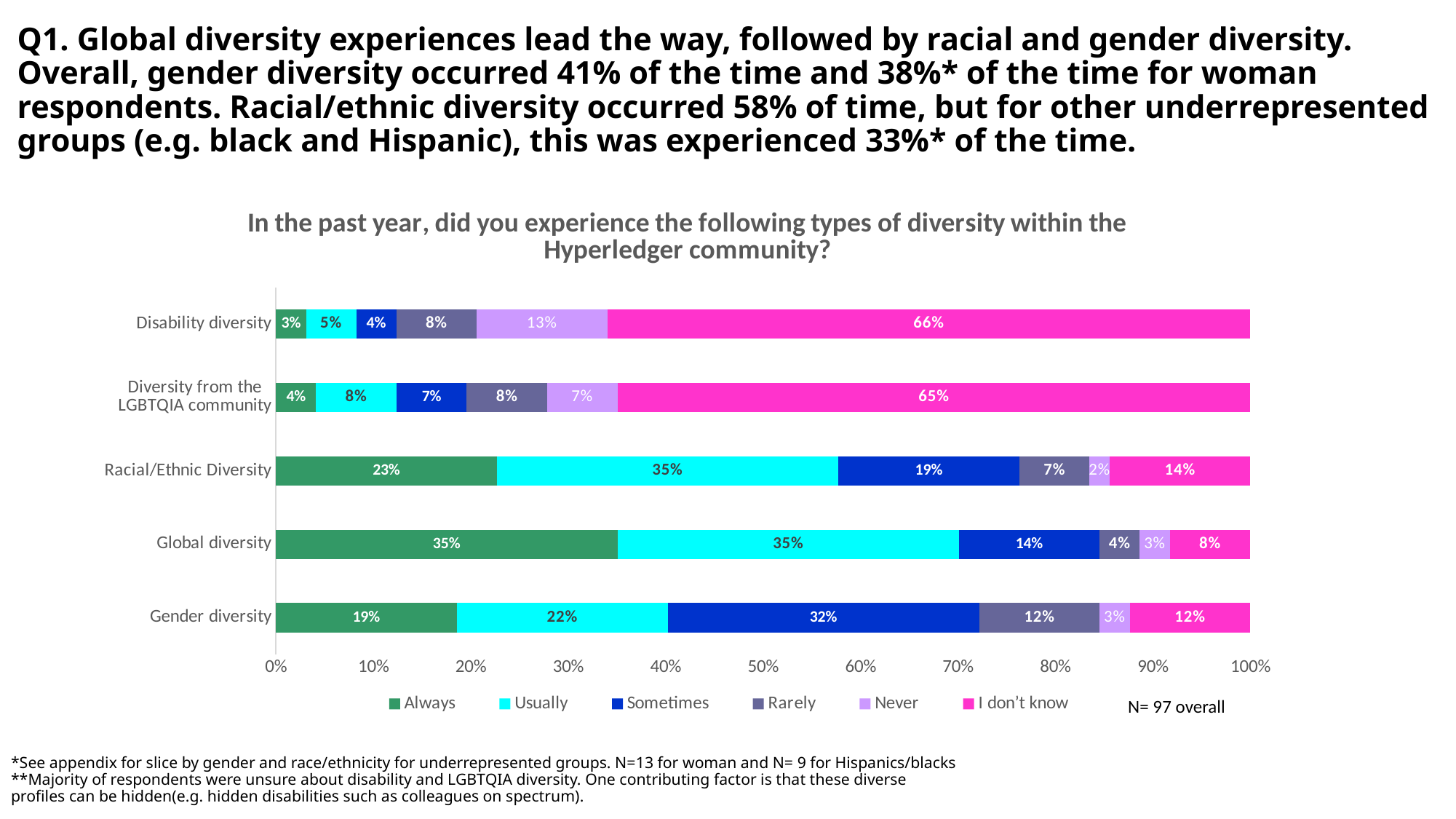
What percentage of respondents answered "I don't know" for Disability diversity? 66% Which category has the lowest "I don't know" value? Global diversity What is the "Usually" value for Racial/Ethnic Diversity? 35% How many series does the legend list? 6 Which category has the highest "Always" value? Global diversity What kind of chart is shown? Stacked bar chart How many diversity categories are shown on the chart? 5 What is the difference between the "Sometimes" values for Gender diversity and Global diversity? 18% What is the "Always" value for Global diversity? 35% Which is larger: the "Rarely" value for Gender diversity or for Racial/Ethnic Diversity? Gender diversity What is the combined "Always" and "Usually" value for Racial/Ethnic Diversity? 58% What is the "Sometimes" value for Gender diversity? 32%